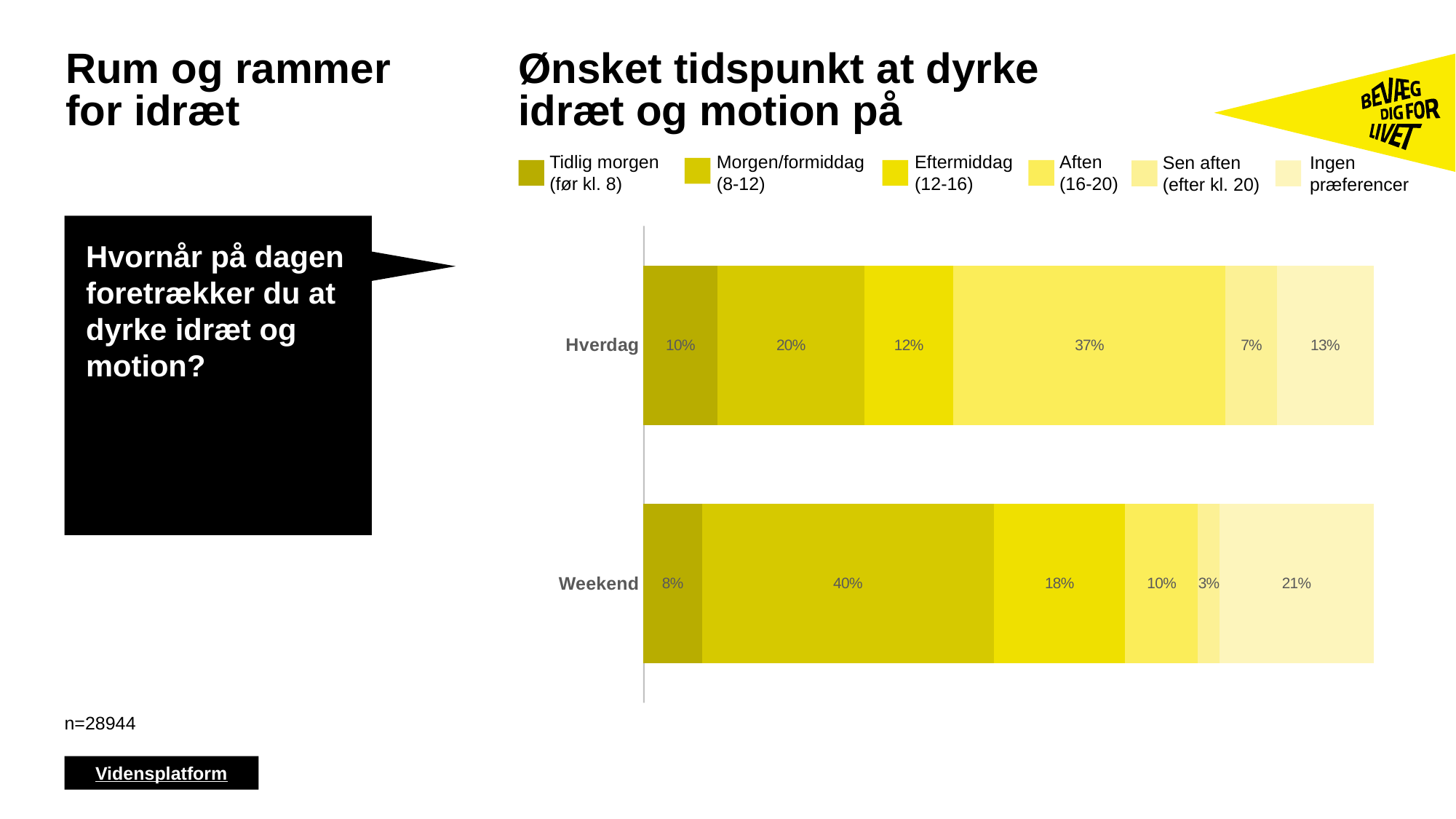
How many categories (bars) does the chart show? 2 How many series does the legend list? 6 What is the value for Ingen præferencer in the Hverdag bar? 13% Which time slot has the highest share in the Hverdag bar? Aften (16-20) Which time slot has the lowest share in the Weekend bar? Sen aften (efter kl. 20) What is the difference between the Morgen/formiddag (8-12) share on Weekend and on Hverdag? 20% What kind of chart is shown on the slide? Stacked bar chart What percentage of respondents prefer Morgen/formiddag (8-12) on Weekend? 40% What is the title of the chart? Ønsket tidspunkt at dyrke idræt og motion på What percentage of respondents prefer Aften (16-20) on Hverdag? 37% What is the value for Sen aften (efter kl. 20) in the Weekend bar? 3% Which is larger: the Eftermiddag (12-16) share on Hverdag or on Weekend? Weekend